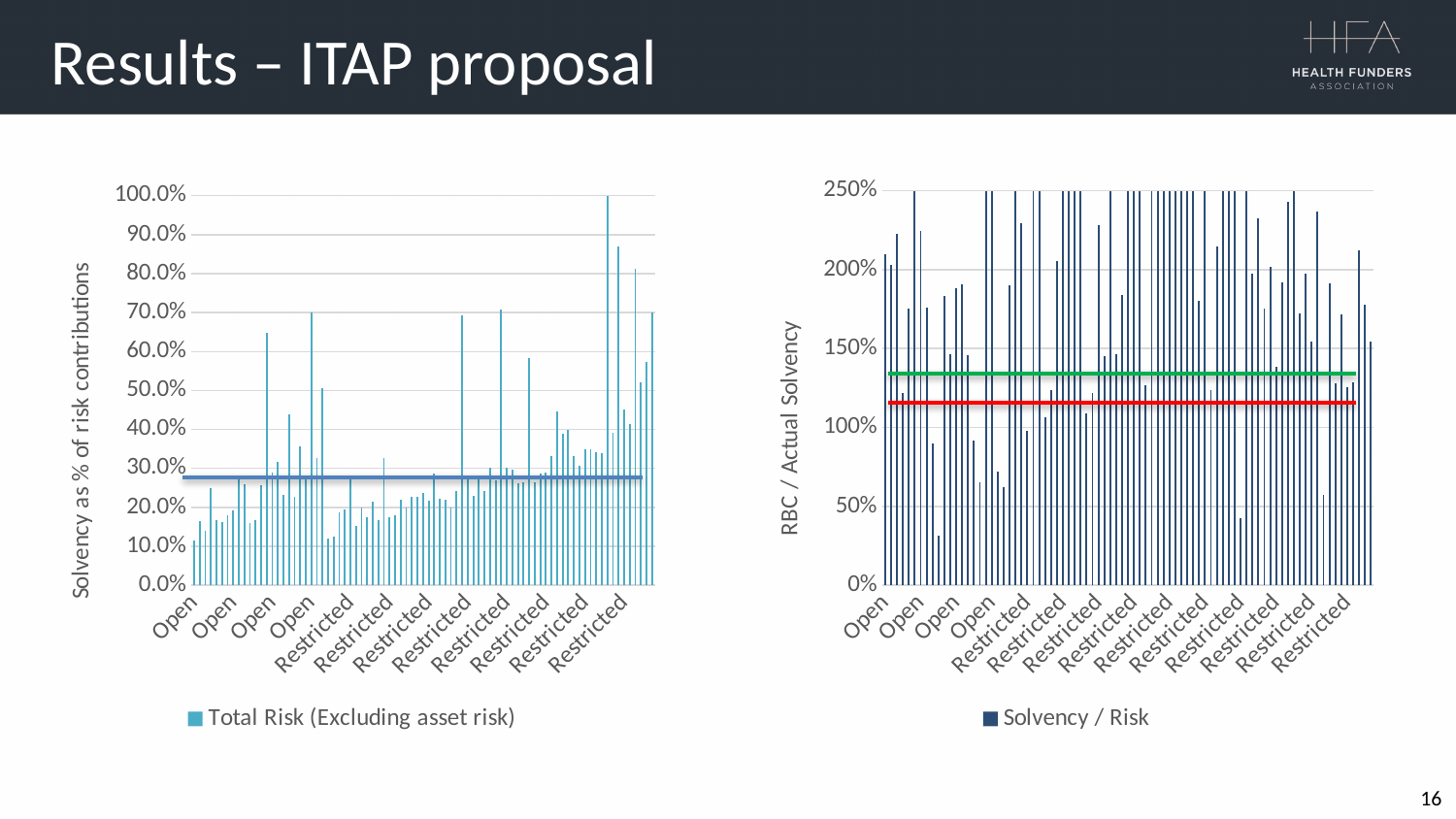
In the left chart, is the first bar on the left greater or less than 20.0%? less In the left chart, is the horizontal blue line greater or less than 20.0%? greater How many series does the legend of the left chart list? 1 What is the legend entry of the left chart? Total Risk (Excluding asset risk) What kind of chart is the left chart, 'Total Risk (Excluding asset risk)'? bar chart What kind of chart is the right chart, 'Solvency / Risk'? bar chart In the right chart, is the horizontal red line greater or less than 150%? less How many series does the legend of the right chart list? 1 What is the vertical axis title of the right chart? RBC / Actual Solvency